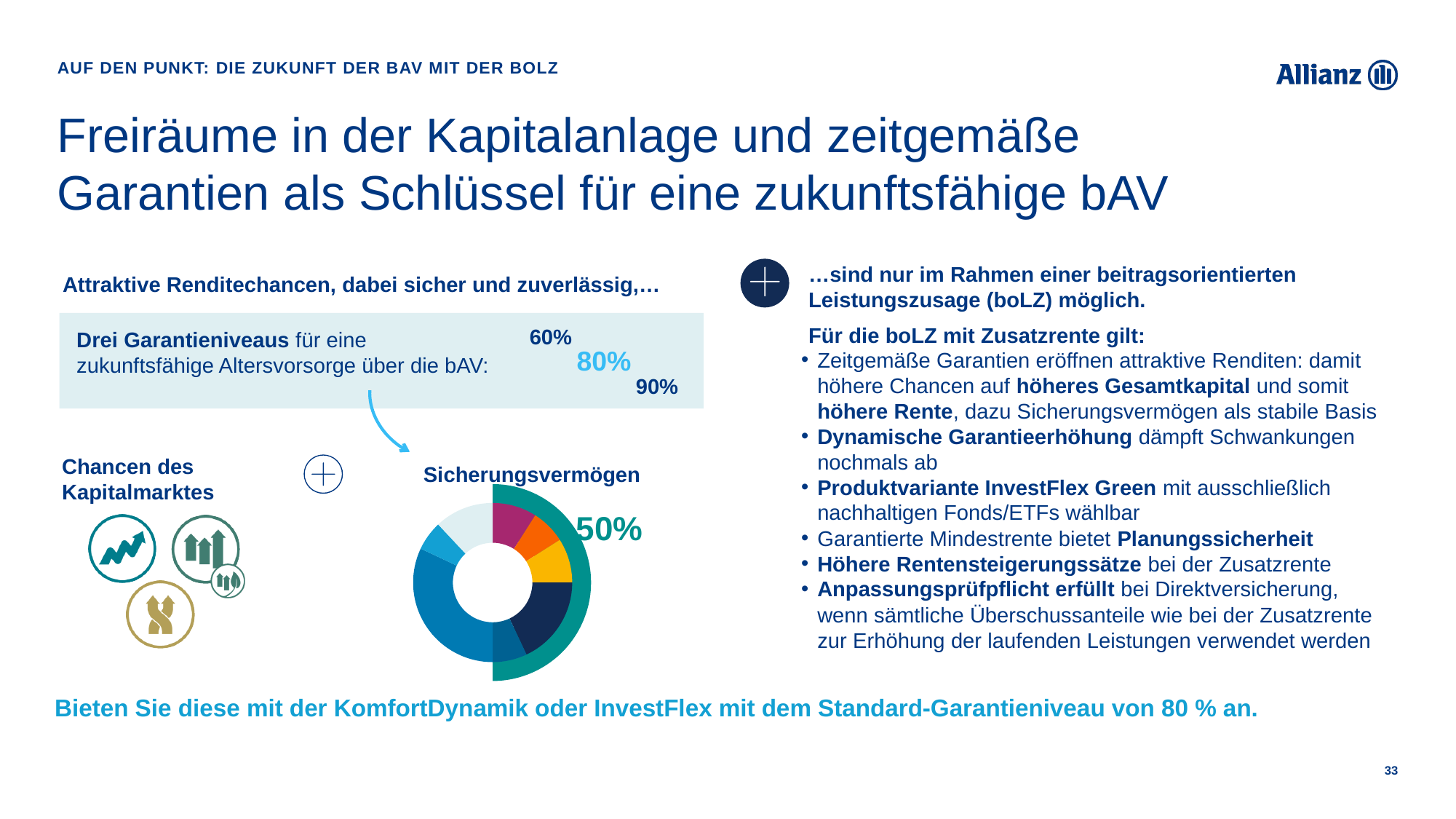
Is the value labelled on the Sicherungsvermögen chart greater or less than 40%? greater What colour is the outer ring of the Sicherungsvermögen chart that carries the 50% label? teal green What percentage value is printed next to the Sicherungsvermögen chart? 50% What kind of chart is shown under the heading "Sicherungsvermögen"? doughnut chart What is the title of the chart on the left side of the slide? Sicherungsvermögen